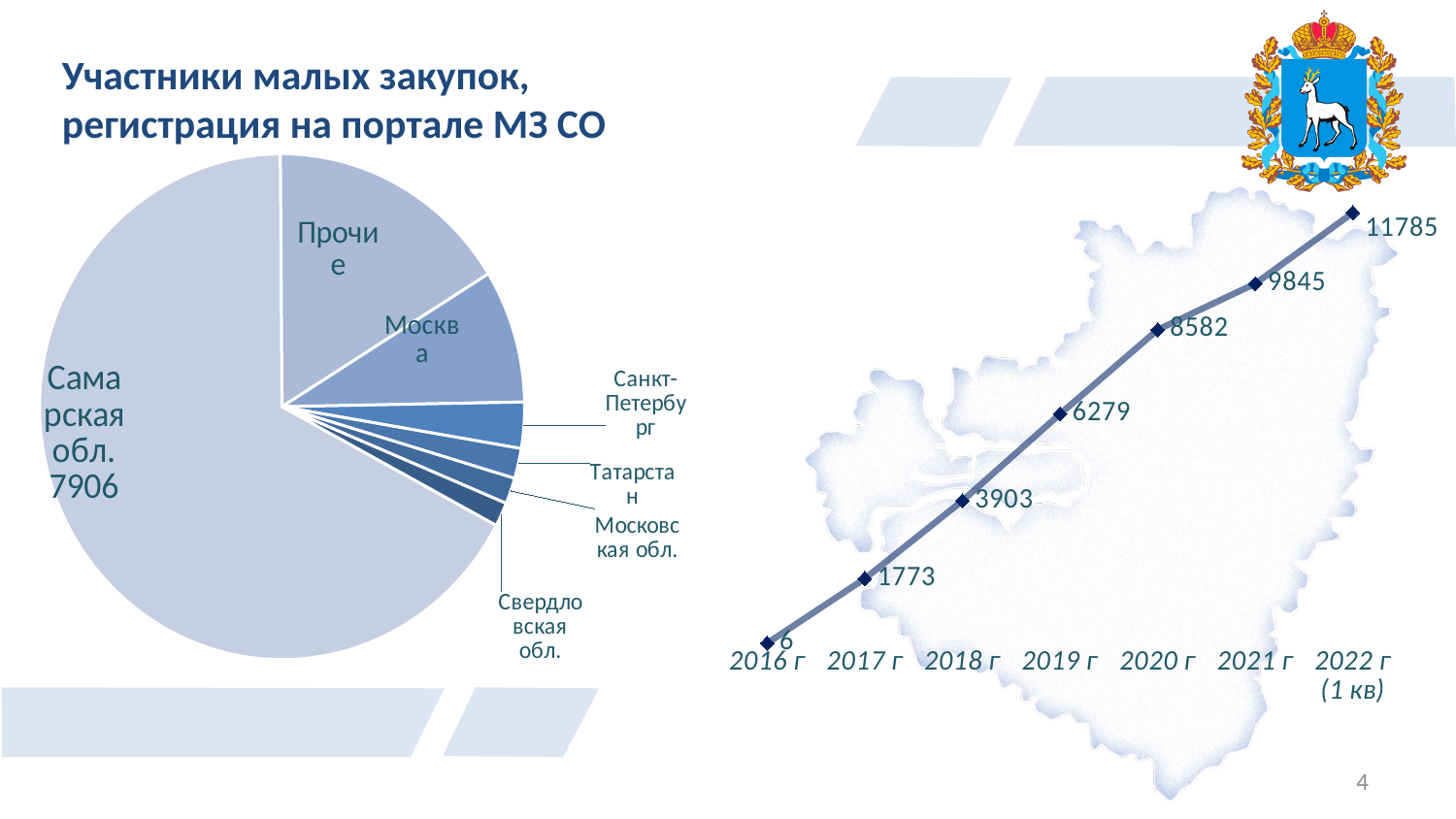
In the line chart on the right, which year has the lowest value? 2016 г What is the title of the pie chart on the left? Участники малых закупок, регистрация на портале МЗ СО How many data points are plotted in the line chart on the right? 7 In the line chart on the right, what is the difference between the values for 2021 г and 2020 г? 1263 What kind of chart is the chart on the left of the slide? Pie chart How many slices does the pie chart on the left have? 7 In the pie chart on the left, which category has the largest slice? Самарская обл. In the pie chart on the left, what value is shown for Самарская обл.? 7906 In the line chart on the right, what is the value for 2019 г? 6279 In the pie chart on the left, which slice is larger: Прочие or Москва? Прочие In the line chart on the right, what is the value for 2022 г (1 кв)? 11785 In the line chart on the right, do the values rise or fall from 2016 г to 2022 г (1 кв)? Rise